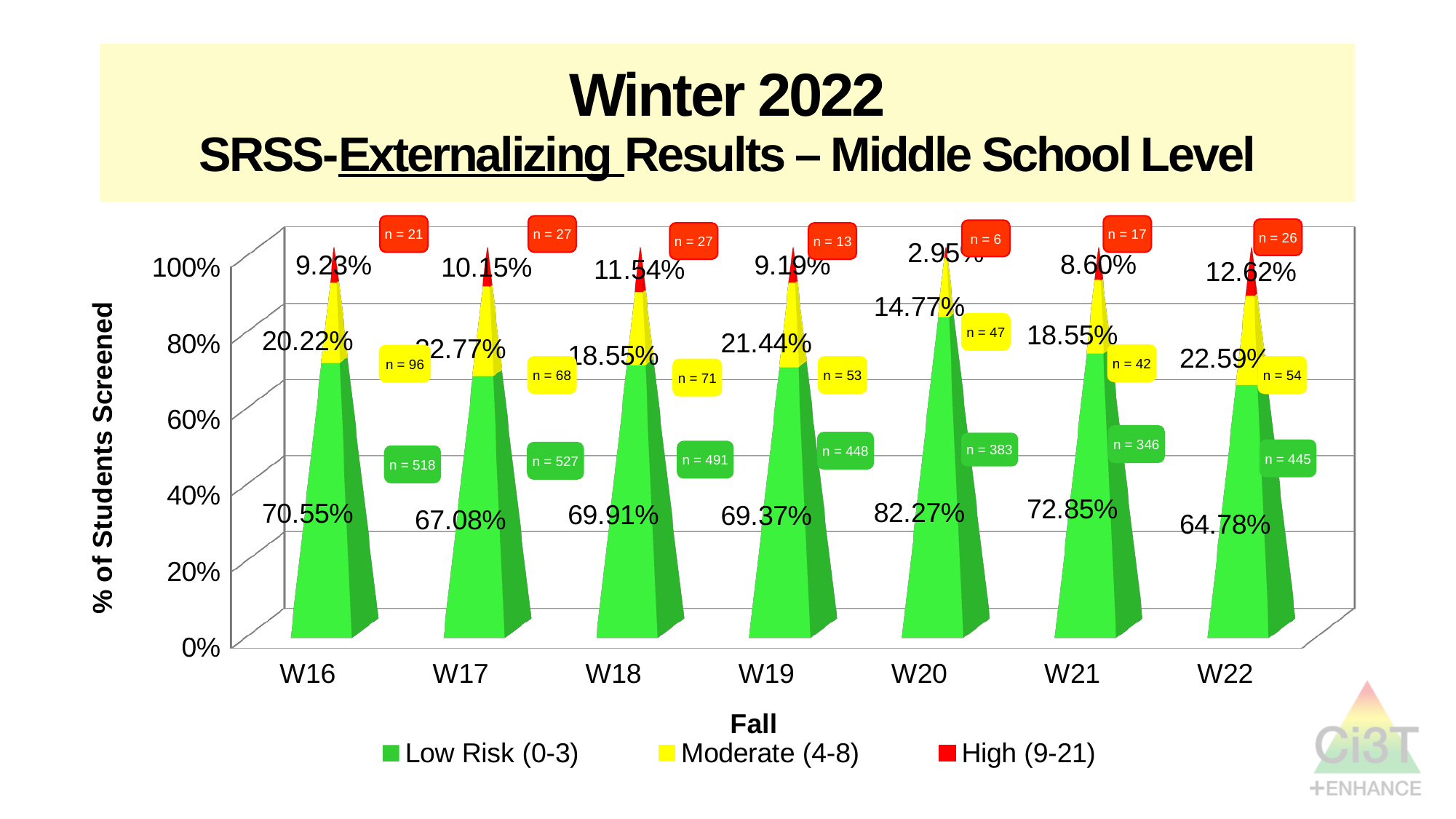
What kind of chart is shown on the slide? Stacked bar chart How many series does the legend list? 3 What is the difference between the Low Risk (0-3) percentages for W20 and W22? 17.49 percentage points What is the n value shown for the Low Risk (0-3) group at W17? n = 527 What is the High (9-21) percentage for W22? 12.62% Which has a larger Low Risk (0-3) percentage, W16 or W17? W16 Which category has the lowest High (9-21) percentage? W20 What is the Moderate (4-8) percentage for W19? 21.44% Which category has the lowest Low Risk (0-3) percentage? W22 What is the Low Risk (0-3) percentage for W20? 82.27% How many categories are shown on the x axis? 7 Which category has the highest Low Risk (0-3) percentage? W20